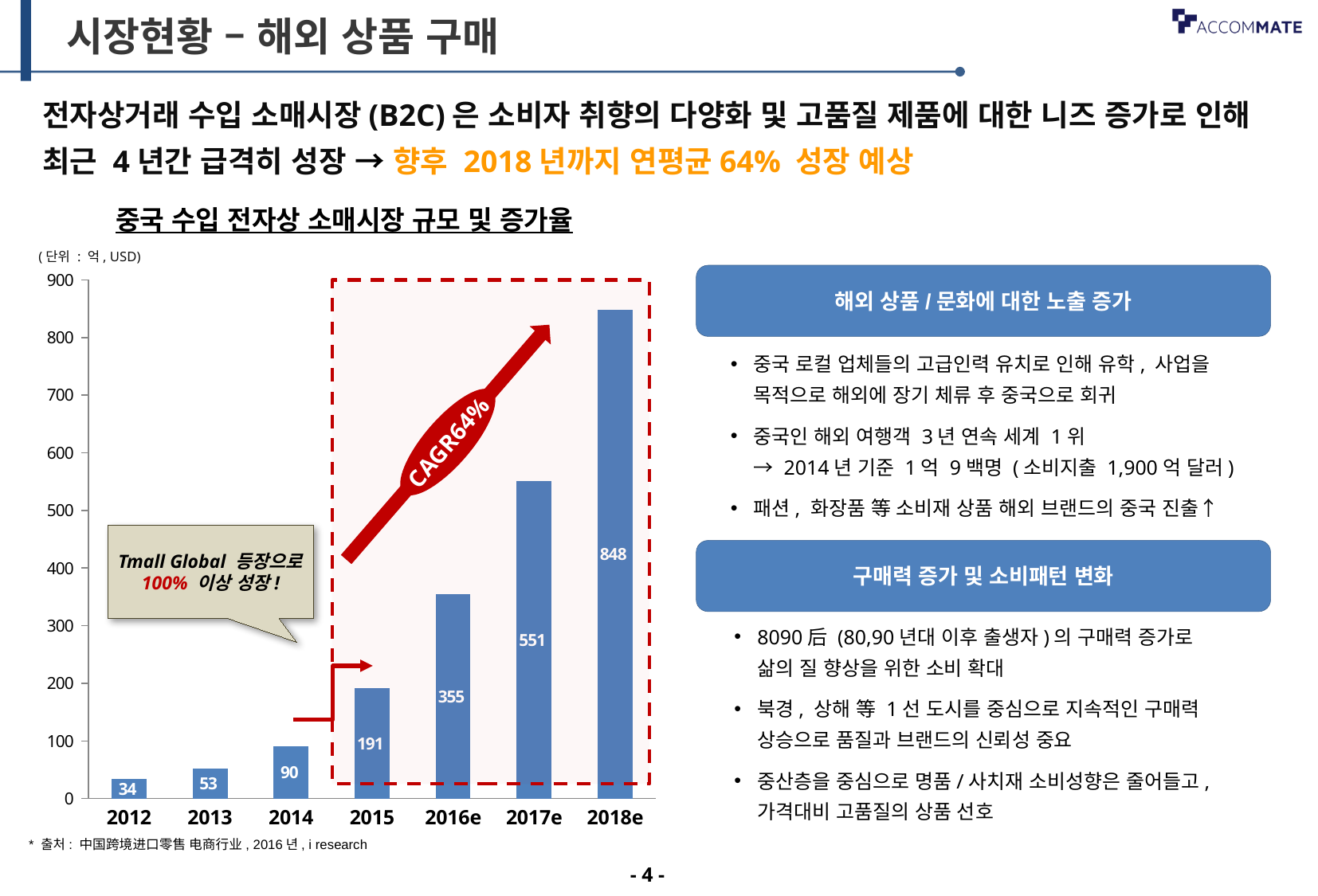
What is the value for 2015? 191 Which year has the highest value? 2018e What CAGR is written on the red arrow in the chart? CAGR64% Which is larger, the value for 2014 or the value for 2013? 2014 Is the value for 2017e greater or less than 500? greater What is the value for 2018e? 848 What is the value for 2012? 34 Which year has the lowest value? 2012 How many years are shown on the x axis? 7 Do the values rise or fall from 2012 to 2018e? rise What is the difference between the values for 2017e and 2016e? 196 What kind of chart is shown? bar chart